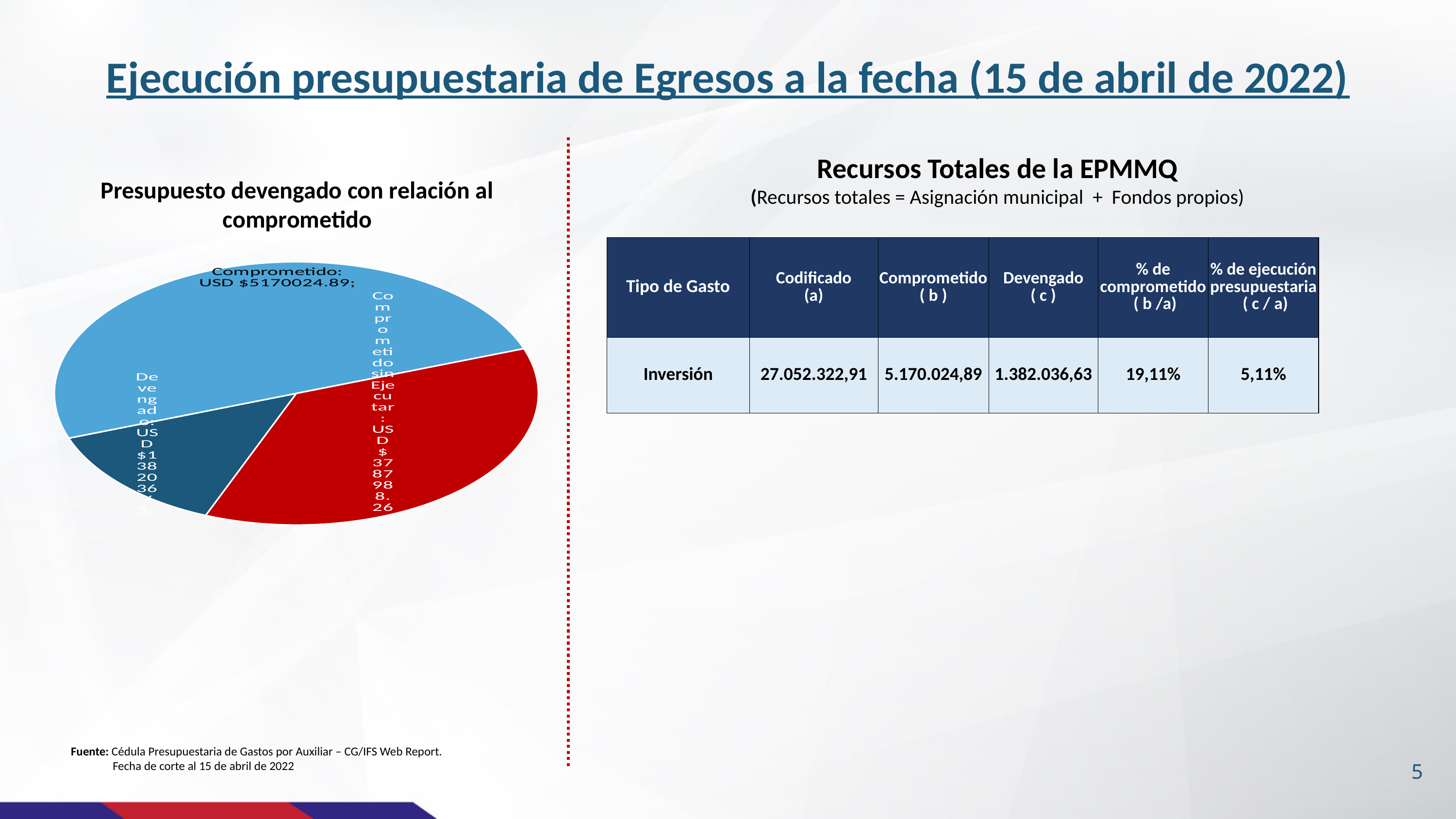
What kind of chart is shown on the left side of the slide? Pie chart Which slice of the pie chart is the largest? Comprometido In the pie chart, which is larger: Comprometido sin Ejecutar or Devengado? Comprometido sin Ejecutar What is the title of the pie chart? Presupuesto devengado con relación al comprometido What colour is the Comprometido slice in the pie chart? Light blue Which slice of the pie chart is the smallest? Devengado What value is shown for the Devengado slice of the pie chart? USD $1382036.63 What value is shown for the Comprometido slice of the pie chart? USD $5170024.89 What value is shown for the Comprometido sin Ejecutar slice of the pie chart? USD $3787988.26 What is the difference between the Comprometido value and the Devengado value in the pie chart? USD $3787988.26 How many slices does the pie chart have? 3